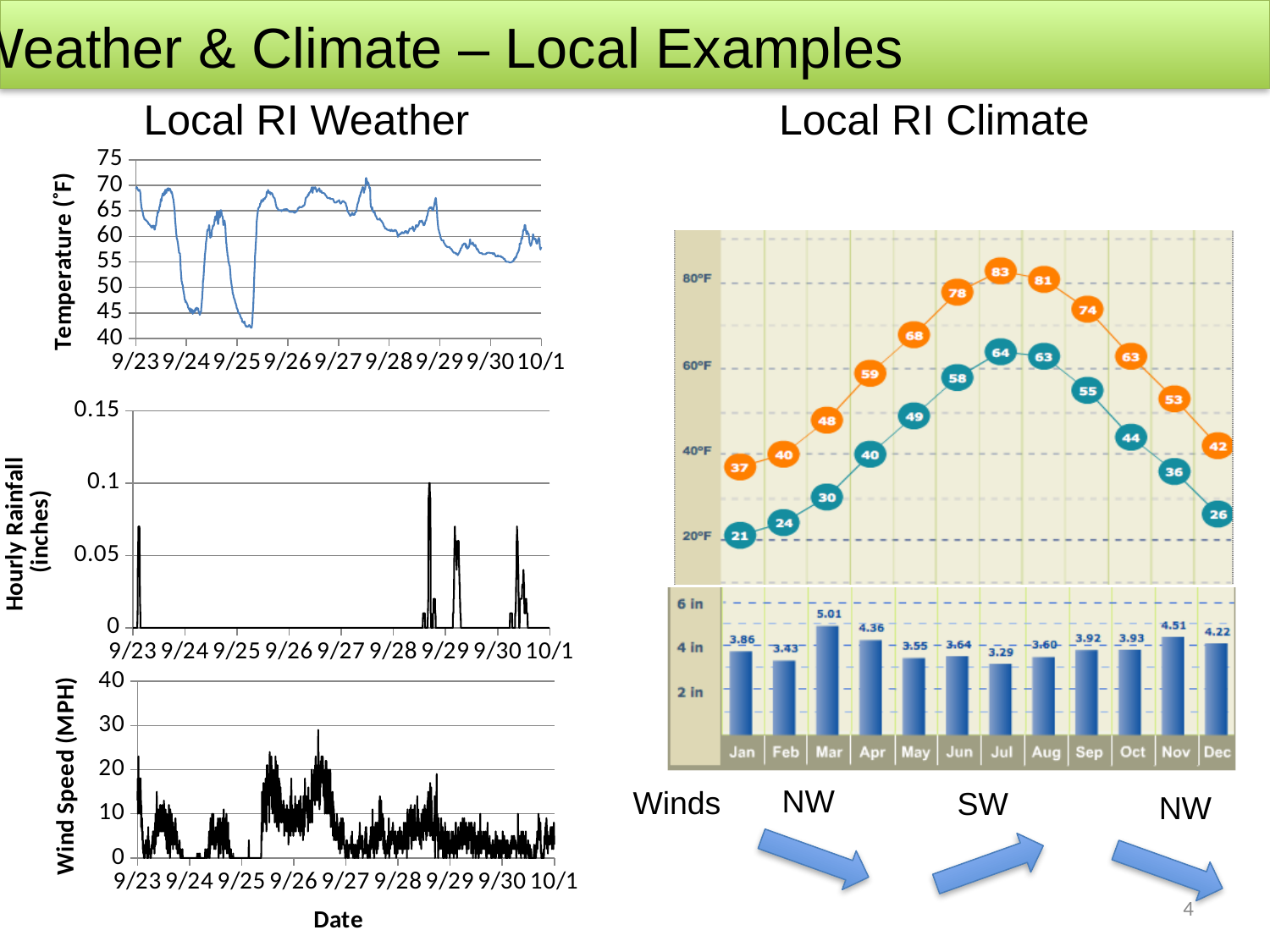
In the Local RI Climate temperature chart, what is the orange (upper) line value for Oct? 63 In the Local RI Climate precipitation bar chart, what is the difference between the Mar value and the Jul value? 1.72 In the Local RI Climate precipitation bar chart, which month has the highest precipitation? Mar In the Local RI Climate precipitation bar chart, what is the value for Nov? 4.51 In the Local RI Climate temperature chart, does the orange (upper) line rise or fall from Jan to Jul? rise In the Local RI Weather wind speed chart, is the peak wind speed greater or less than 20 MPH? greater In the Local RI Climate precipitation bar chart, how many months (bars) are shown? 12 In the Local RI Climate temperature chart, what is the highest value on the orange (upper) line, and in which month? 83, Jul In the Local RI Climate temperature chart, which is larger: the orange value for Aug or the orange value for Jun? Aug What kind of chart is the Local RI Climate precipitation chart? bar chart In the Local RI Climate temperature chart, what is the lowest value on the teal (lower) line, and in which month? 21, Jan In the Local RI Climate precipitation bar chart, which month has the lowest precipitation? Jul